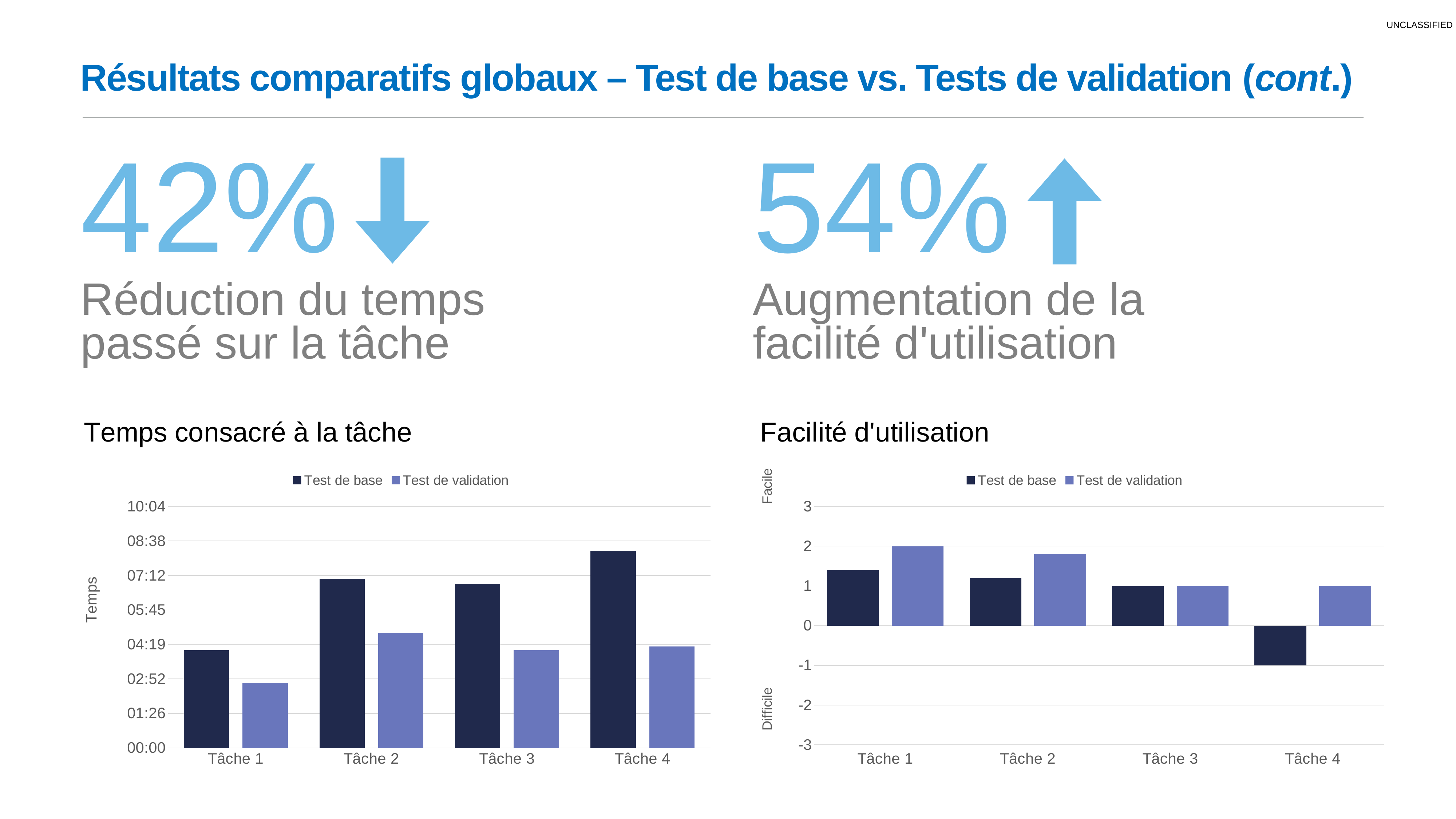
In the "Temps consacré à la tâche" chart, is the Test de base value for Tâche 4 greater or less than 07:12? greater What are the two labels written along the y axis of the "Facilité d'utilisation" chart? Facile and Difficile In the "Temps consacré à la tâche" chart, for Tâche 2, which is larger: Test de base or Test de validation? Test de base What kind of chart is the "Temps consacré à la tâche" chart? bar chart In the "Facilité d'utilisation" chart, what is the Test de validation value for Tâche 1? 2 In the "Temps consacré à la tâche" chart, which task has the lowest Test de validation value? Tâche 1 How many tasks are shown on the x axis of the "Temps consacré à la tâche" chart? 4 In the "Facilité d'utilisation" chart, which task has the lowest Test de base value? Tâche 4 How many series does the legend of the "Temps consacré à la tâche" chart list? 2 In the "Facilité d'utilisation" chart, is the Test de base value for Tâche 4 greater or less than 0? less In the "Temps consacré à la tâche" chart, which task has the highest Test de base value? Tâche 4